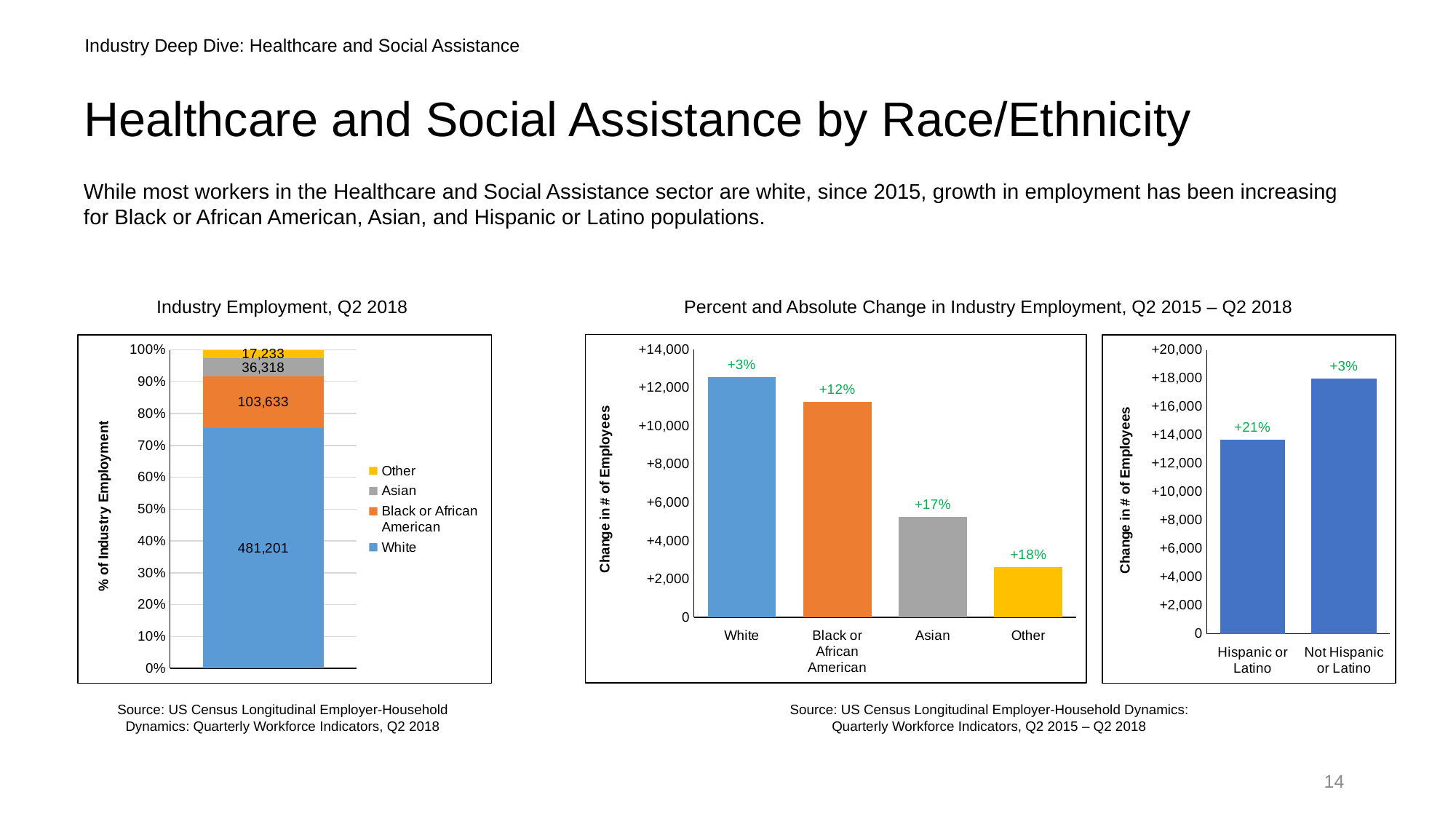
In the 'Industry Employment, Q2 2018' chart, what is the difference between the White and Black or African American values? 377,568 In the 'Industry Employment, Q2 2018' chart, what is the total of all four segments in the stacked bar? 638,385 In the 'Industry Employment, Q2 2018' chart, which group has the smallest value? Other In the 'Percent and Absolute Change in Industry Employment, Q2 2015 – Q2 2018' chart by race, which category has the smallest absolute change in number of employees? Other How many series does the legend of the 'Industry Employment, Q2 2018' chart list? 4 In the rightmost chart (Hispanic or Latino vs Not Hispanic or Latino), which category has the larger absolute change in number of employees? Not Hispanic or Latino In the 'Industry Employment, Q2 2018' chart, what is the value shown for Asian? 36,318 In the 'Industry Employment, Q2 2018' chart, what is the value shown for White? 481,201 In the 'Percent and Absolute Change in Industry Employment, Q2 2015 – Q2 2018' chart by race, is the change in number of employees for Asian greater or less than 6,000? less In the rightmost chart (Hispanic or Latino vs Not Hispanic or Latino), what percent change is shown for Hispanic or Latino? +21% In the 'Percent and Absolute Change in Industry Employment, Q2 2015 – Q2 2018' chart by race, what percent change is shown for Asian? +17% In the 'Percent and Absolute Change in Industry Employment, Q2 2015 – Q2 2018' chart by race, how many categories are shown on the x axis? 4